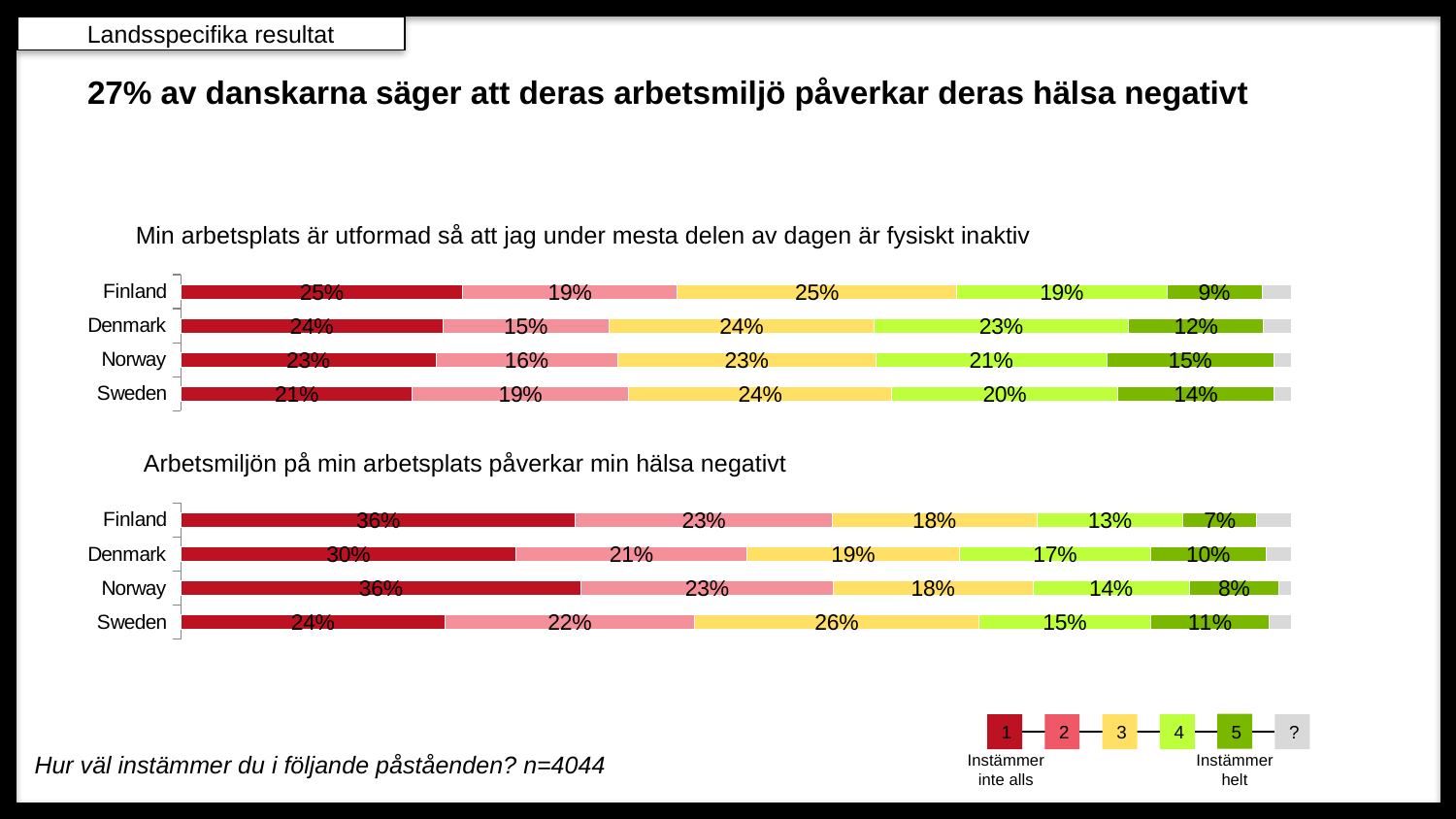
In the top chart ("Min arbetsplats är utformad så att jag under mesta delen av dagen är fysiskt inaktiv"), which is larger: Denmark's share answering 4 or Norway's share answering 4? Denmark In the bottom chart ("Arbetsmiljön på min arbetsplats påverkar min hälsa negativt"), what percentage of respondents in Sweden answered 3? 26% What type of chart is used for "Arbetsmiljön på min arbetsplats påverkar min hälsa negativt"? Stacked bar chart In the bottom chart ("Arbetsmiljön på min arbetsplats påverkar min hälsa negativt"), what percentage of respondents in Denmark answered 1 (Instämmer inte alls)? 30% In the bottom chart ("Arbetsmiljön på min arbetsplats påverkar min hälsa negativt"), which country has the lowest share answering 5 (Instämmer helt)? Finland In the bottom chart ("Arbetsmiljön på min arbetsplats påverkar min hälsa negativt"), what is the difference between Denmark's and Norway's share answering 5 (Instämmer helt)? 2 percentage points In the bottom chart ("Arbetsmiljön på min arbetsplats påverkar min hälsa negativt"), what is the difference between Finland's and Sweden's share answering 1 (Instämmer inte alls)? 12 percentage points How many response categories does the legend at the bottom of the slide list? 6 How many countries are shown in the top chart ("Min arbetsplats är utformad så att jag under mesta delen av dagen är fysiskt inaktiv")? 4 According to the legend, what does the response value 5 mean? Instämmer helt In the top chart ("Min arbetsplats är utformad så att jag under mesta delen av dagen är fysiskt inaktiv"), which country has the highest share answering 5 (Instämmer helt)? Norway In the top chart ("Min arbetsplats är utformad så att jag under mesta delen av dagen är fysiskt inaktiv"), what percentage of respondents in Finland answered 1 (Instämmer inte alls)? 25%